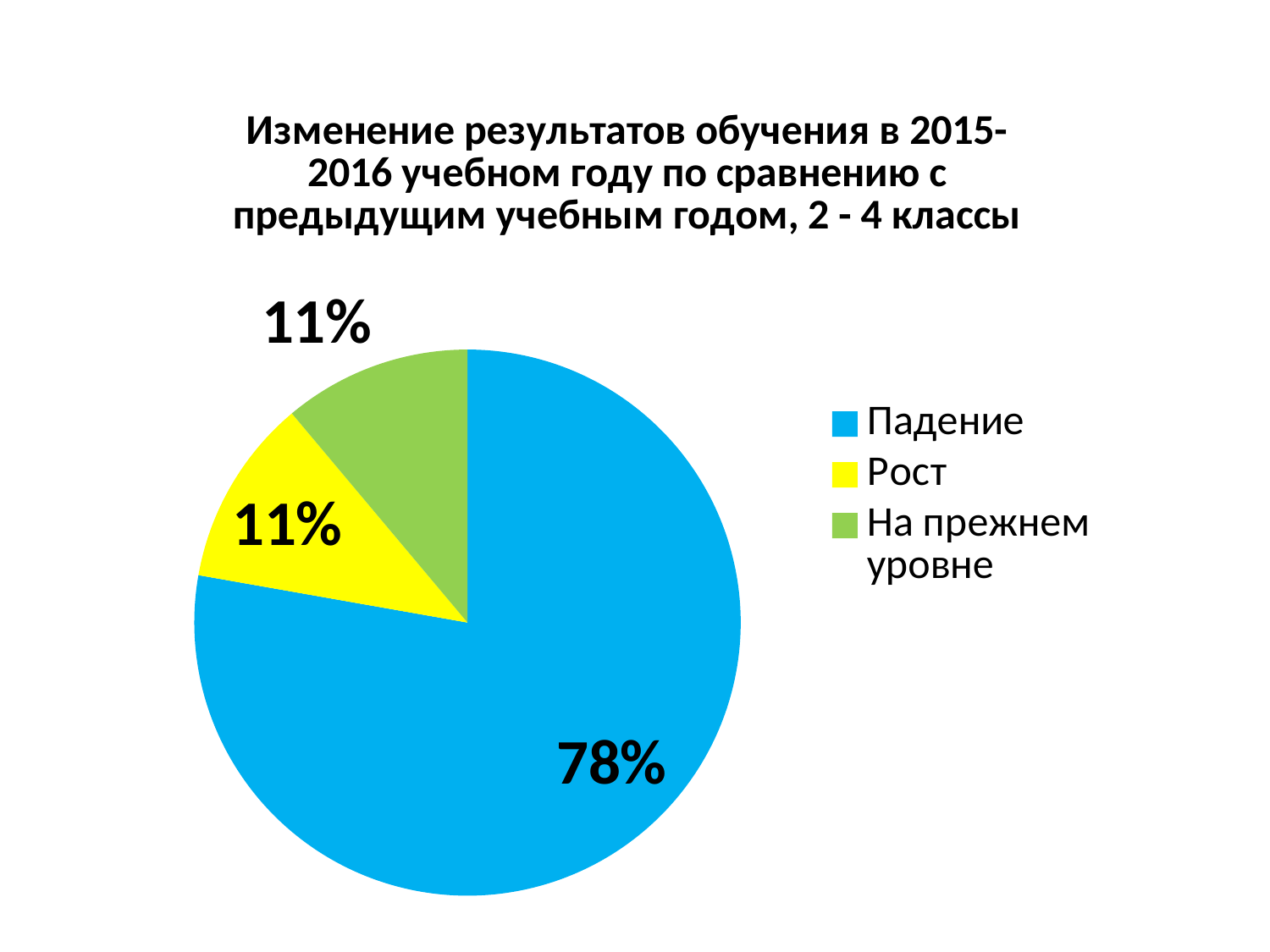
What is the difference between the share for "Падение" and the share for "Рост"? 67% What type of chart is shown on the slide? pie chart How many slices does the pie chart have? 3 What colour is the slice for "Рост"? yellow Which is larger, the share for "Падение" or the share for "На прежнем уровне"? Падение Which category has the largest slice of the pie? Падение What share of the pie does "Падение" represent? 78% What share of the pie does "На прежнем уровне" represent? 11% How many entries does the legend list? 3 What colour is the slice for "Падение"? blue What share of the pie does "Рост" represent? 11%